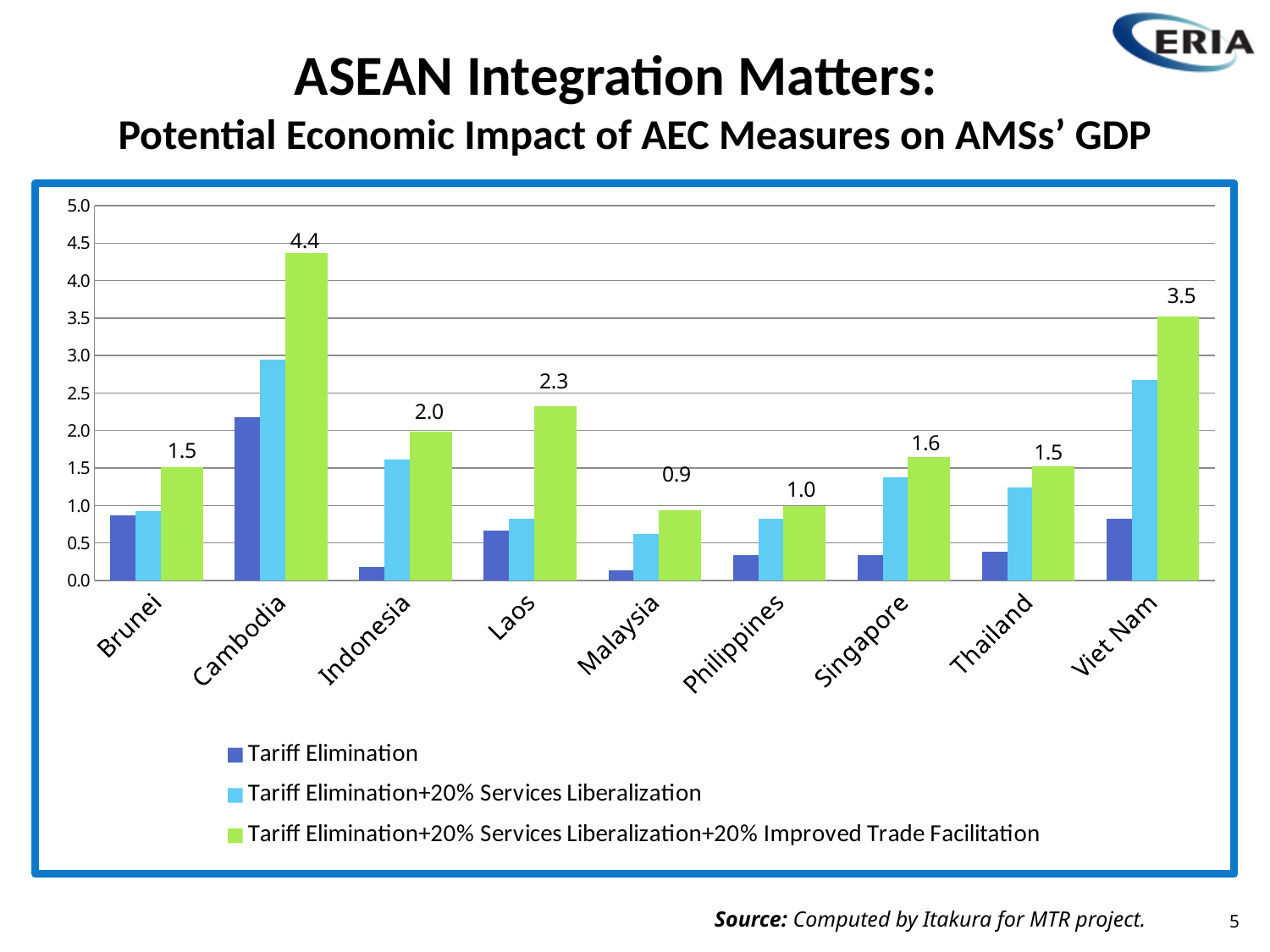
Which country has the lowest value in the Tariff Elimination+20% Services Liberalization+20% Improved Trade Facilitation series? Malaysia How many countries are shown on the x axis of the chart? 9 What is the value for Cambodia in the Tariff Elimination+20% Services Liberalization+20% Improved Trade Facilitation series? 4.4 What kind of chart is shown on the slide? bar chart What is the value for Viet Nam in the Tariff Elimination+20% Services Liberalization+20% Improved Trade Facilitation series? 3.5 What colour represents the Tariff Elimination+20% Services Liberalization+20% Improved Trade Facilitation series? green Which country has the highest value in the Tariff Elimination+20% Services Liberalization+20% Improved Trade Facilitation series? Cambodia Is the value for Indonesia in the Tariff Elimination series greater or less than 0.5? less Is the value for Cambodia in the Tariff Elimination+20% Services Liberalization series greater or less than 2.5? greater In the Tariff Elimination+20% Services Liberalization+20% Improved Trade Facilitation series, which is larger: Laos or Indonesia? Laos What is the difference between Cambodia and Viet Nam in the Tariff Elimination+20% Services Liberalization+20% Improved Trade Facilitation series? 0.9 How many series does the legend list? 3